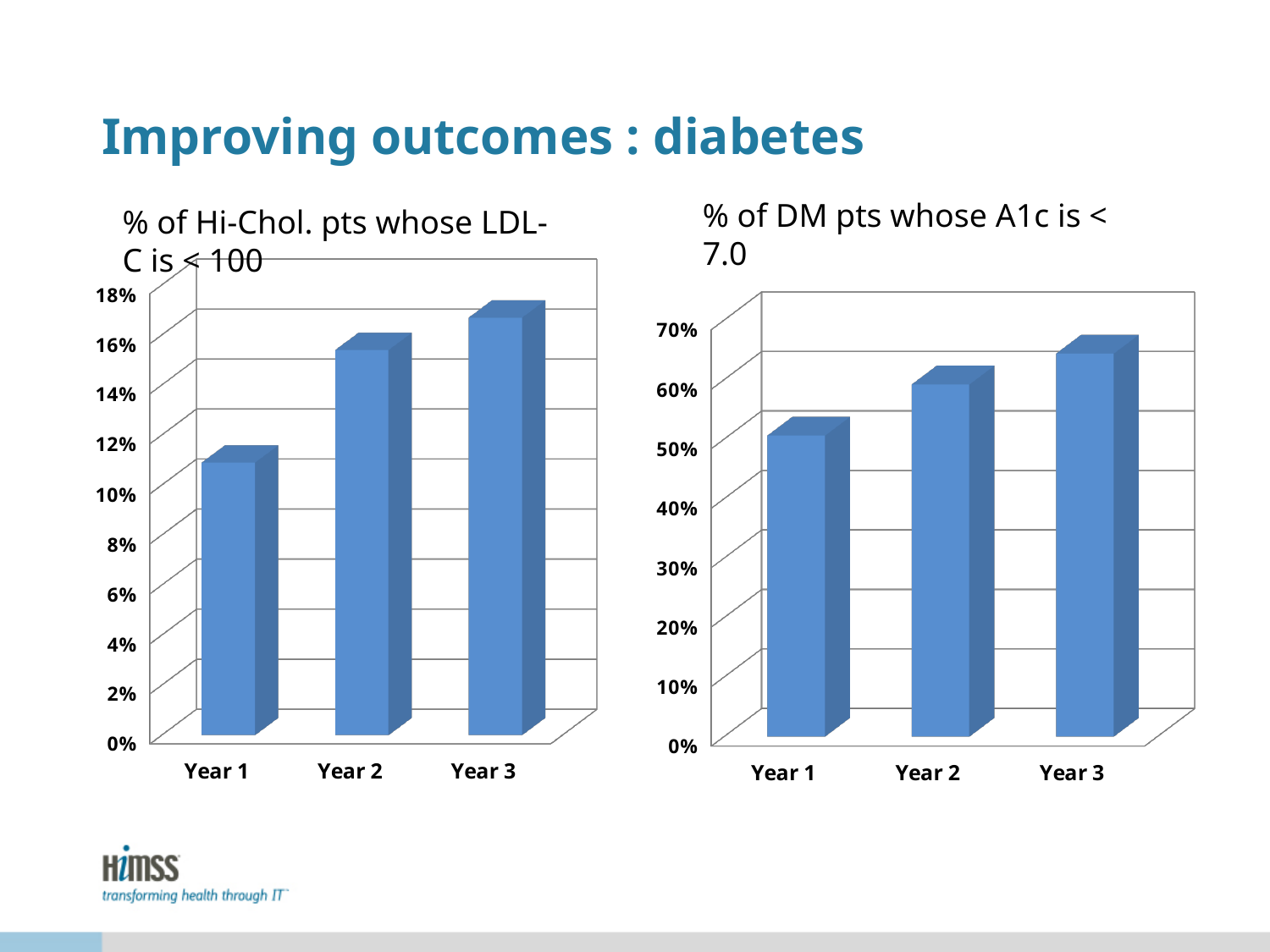
On the left chart (% of Hi-Chol. pts whose LDL-C is < 100), which year has the highest value? Year 3 On the right chart (% of DM pts whose A1c is < 7.0), which is larger, the value for Year 1 or the value for Year 3? Year 3 On the left chart (% of Hi-Chol. pts whose LDL-C is < 100), is the value for Year 2 greater or less than 14%? greater On the left chart (% of Hi-Chol. pts whose LDL-C is < 100), how many years are shown on the x axis? 3 On the left chart (% of Hi-Chol. pts whose LDL-C is < 100), is the value for Year 1 greater or less than 12%? less On the left chart (% of Hi-Chol. pts whose LDL-C is < 100), do the values rise or fall from Year 1 to Year 3? rise On the right chart (% of DM pts whose A1c is < 7.0), is the value for Year 3 greater or less than 70%? less On the right chart (% of DM pts whose A1c is < 7.0), which year has the highest value? Year 3 What kind of chart is the right chart (% of DM pts whose A1c is < 7.0)? bar chart On the left chart (% of Hi-Chol. pts whose LDL-C is < 100), which year has the lowest value? Year 1 On the right chart (% of DM pts whose A1c is < 7.0), which year has the lowest value? Year 1